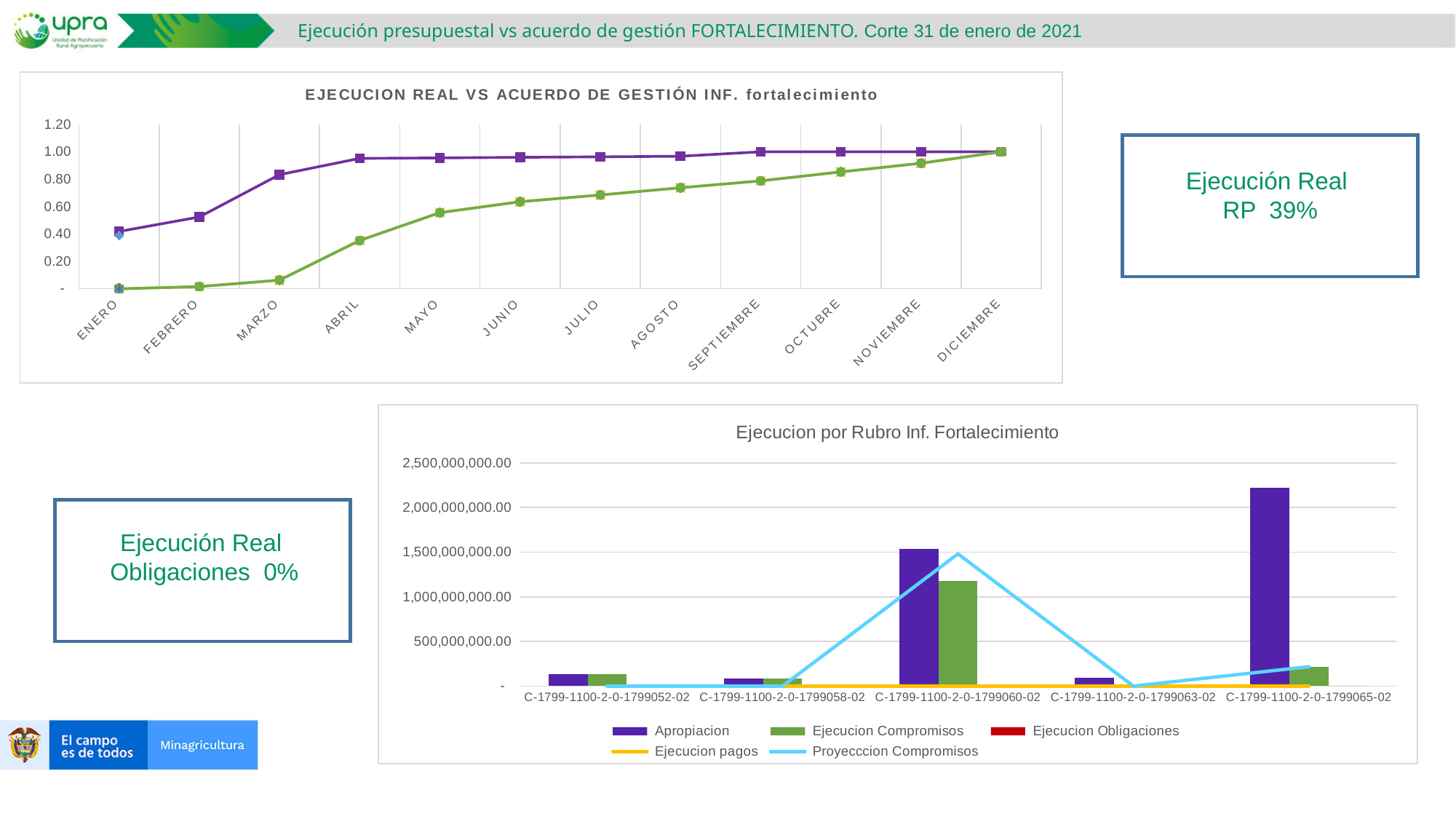
In the top chart 'EJECUCION REAL VS ACUERDO DE GESTIÓN INF. fortalecimiento', how many months are shown on the x axis? 12 In the bottom chart 'Ejecucion por Rubro Inf. Fortalecimiento', is the Ejecucion Compromisos for C-1799-1100-2-0-1799060-02 greater or less than 1,500,000,000.00? less In the top chart 'EJECUCION REAL VS ACUERDO DE GESTIÓN INF. fortalecimiento', is the value of the purple line at ENERO greater or less than 0.60? less In the bottom chart 'Ejecucion por Rubro Inf. Fortalecimiento', which category has the highest Apropiacion? C-1799-1100-2-0-1799065-02 In the bottom chart 'Ejecucion por Rubro Inf. Fortalecimiento', how many series does the legend list? 5 What type of chart is the bottom chart 'Ejecucion por Rubro Inf. Fortalecimiento'? combination bar and line chart In the bottom chart 'Ejecucion por Rubro Inf. Fortalecimiento', which is larger for C-1799-1100-2-0-1799060-02: Apropiacion or Ejecucion Compromisos? Apropiacion In the bottom chart 'Ejecucion por Rubro Inf. Fortalecimiento', is the Apropiacion for C-1799-1100-2-0-1799065-02 greater or less than 2,000,000,000.00? greater In the bottom chart 'Ejecucion por Rubro Inf. Fortalecimiento', how many categories are shown on the x axis? 5 What type of chart is the top chart titled 'EJECUCION REAL VS ACUERDO DE GESTIÓN INF. fortalecimiento'? line chart In the top chart 'EJECUCION REAL VS ACUERDO DE GESTIÓN INF. fortalecimiento', do the lines rise or fall from ENERO to DICIEMBRE? rise